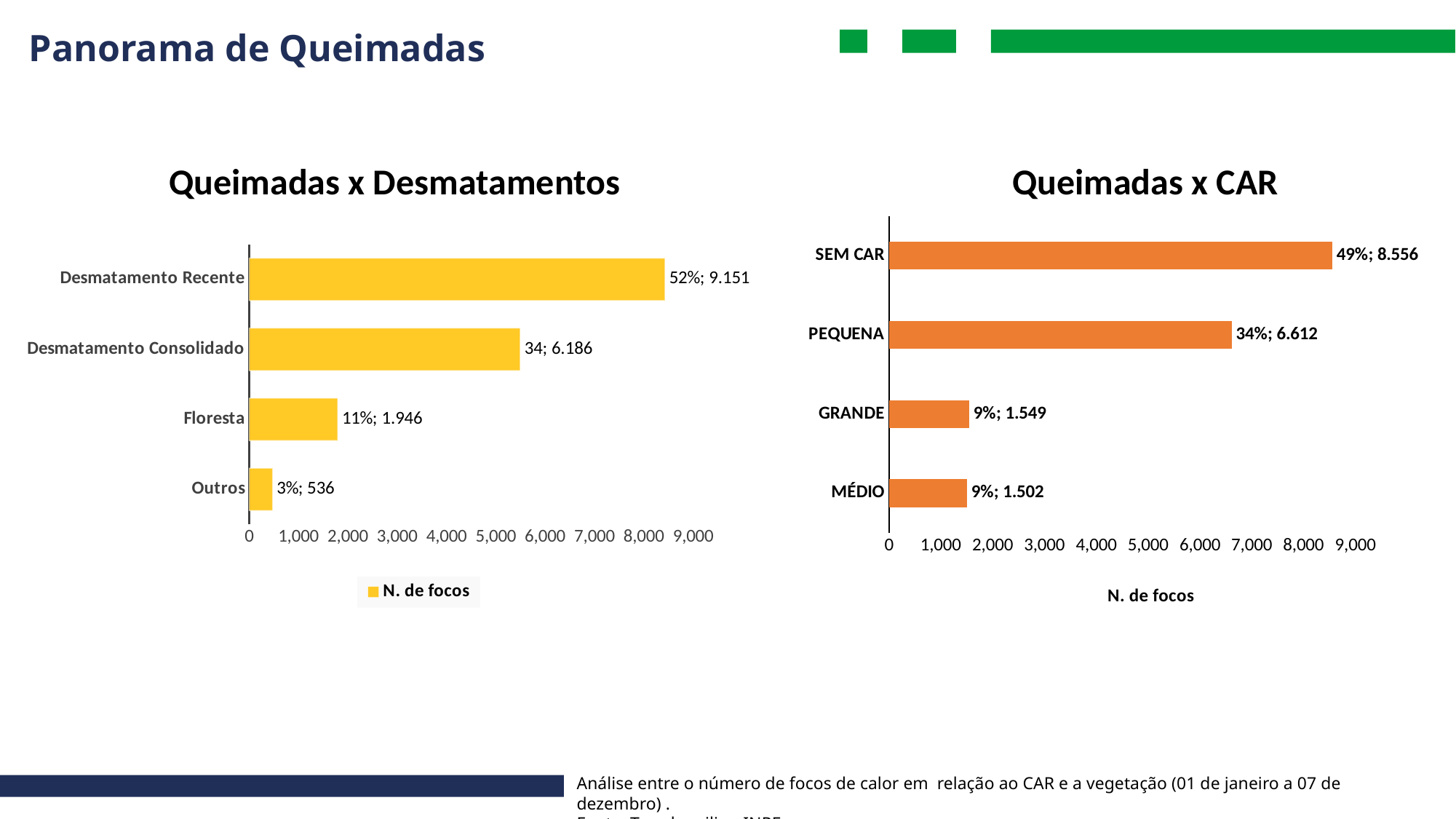
What type of chart is 'Queimadas x CAR'? bar chart In the 'Queimadas x Desmatamentos' chart, which category has the lowest number of focos? Outros In the 'Queimadas x CAR' chart, which category has the highest number of focos? SEM CAR In the 'Queimadas x CAR' chart, is the value for PEQUENA greater or less than 6,000? greater In the 'Queimadas x Desmatamentos' chart, what is the data label for Floresta? 11%; 1.946 In the 'Queimadas x CAR' chart, what is the data label for PEQUENA? 34%; 6.612 In the 'Queimadas x Desmatamentos' chart, how many categories are shown? 4 In the 'Queimadas x Desmatamentos' chart, what series name does the legend show? N. de focos In the 'Queimadas x CAR' chart, what is the difference in focos between GRANDE (1.549) and MÉDIO (1.502)? 47 In the 'Queimadas x CAR' chart, what is the data label for SEM CAR? 49%; 8.556 In the 'Queimadas x Desmatamentos' chart, what is the difference in focos between Desmatamento Recente (9.151) and Desmatamento Consolidado (6.186)? 2.965 In the 'Queimadas x Desmatamentos' chart, what is the data label for Desmatamento Recente? 52%; 9.151